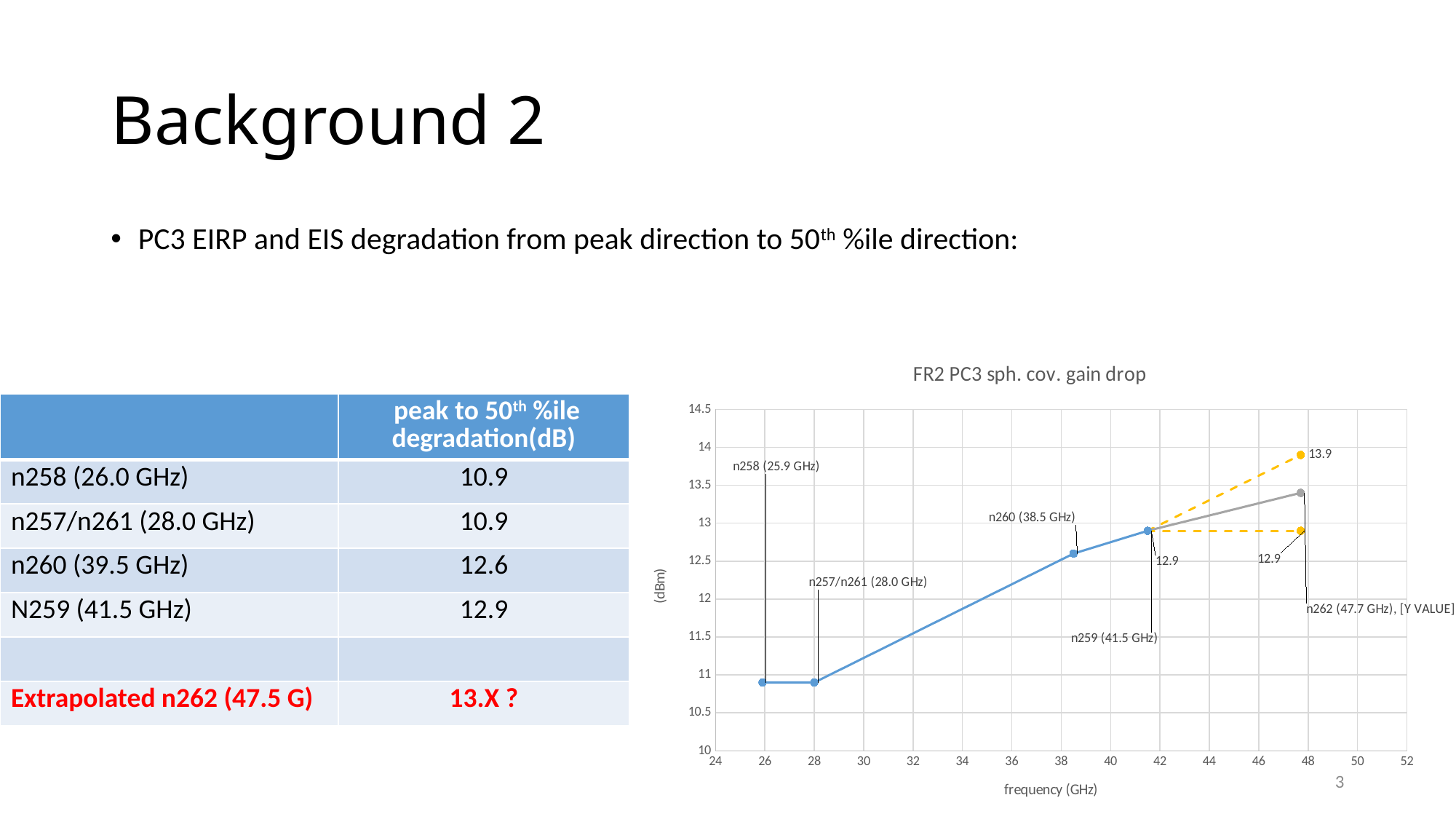
What kind of chart is shown on the slide? line chart Do the values on the solid blue line rise or fall as frequency increases from 26 GHz to 41.5 GHz? rise What is the difference between the upper dashed-line value (13.9) and the lower dashed-line value (12.9) at 47.7 GHz? 1.0 What is the title of the chart? FR2 PC3 sph. cov. gain drop What is the label of the x axis of the chart? frequency (GHz) Which labelled value on the chart is the highest? 13.9 Which has the larger value on the chart, n260 (38.5 GHz) or n259 (41.5 GHz)? n259 (41.5 GHz) What value is labelled at the end of the upper dashed line at 47.7 GHz? 13.9 What value is labelled at the n259 (41.5 GHz) point on the chart? 12.9 What value is labelled at the end of the lower dashed line at 47.7 GHz? 12.9 Is the value for n258 (25.9 GHz) greater or less than 11.5? less Is the value for n260 (38.5 GHz) greater or less than 12? greater